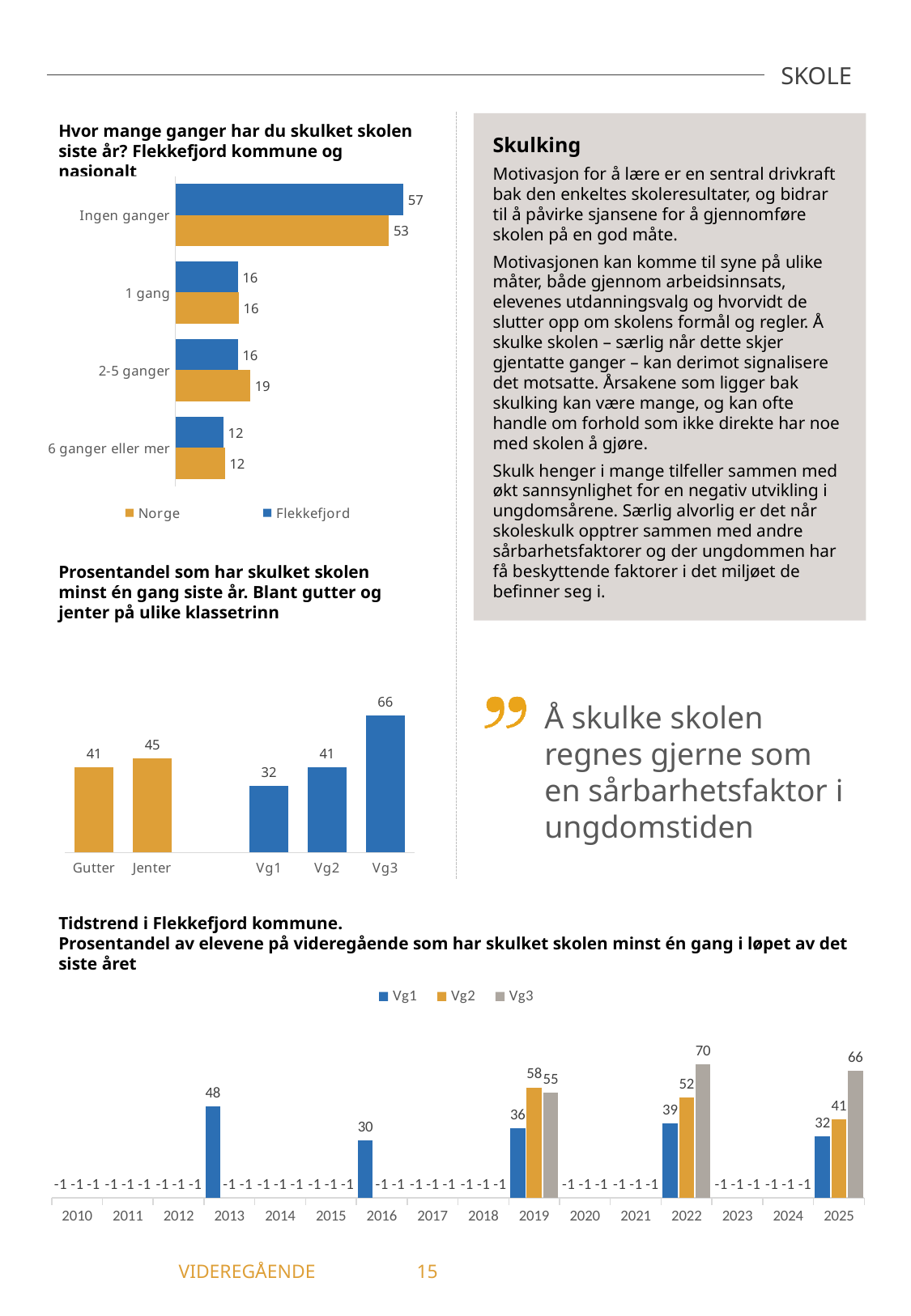
In the chart 'Tidstrend i Flekkefjord kommune', what is the value for Vg3 in 2022? 70 In the chart 'Prosentandel som har skulket skolen minst én gang siste år', which category has the lowest value? Vg1 In the chart 'Hvor mange ganger har du skulket skolen siste år?', what is the value for Flekkefjord in the category 'Ingen ganger'? 57 In the chart 'Tidstrend i Flekkefjord kommune', which is larger in 2019: the value for Vg2 or Vg3? Vg2 What kind of chart is the 'Tidstrend i Flekkefjord kommune' chart? Bar chart In the chart 'Prosentandel som har skulket skolen minst én gang siste år', what is the difference between the values for Vg3 and Vg1? 34 In the chart 'Prosentandel som har skulket skolen minst én gang siste år', what is the value for Jenter? 45 In the chart 'Prosentandel som har skulket skolen minst én gang siste år', which category has the highest value? Vg3 In the chart 'Hvor mange ganger har du skulket skolen siste år?', what is the difference between the Flekkefjord and Norge values for 'Ingen ganger'? 4 In the chart 'Tidstrend i Flekkefjord kommune', what is the value for Vg1 in 2013? 48 In the chart 'Hvor mange ganger har du skulket skolen siste år?', what is the value for Norge in the category '2-5 ganger'? 19 In the chart 'Hvor mange ganger har du skulket skolen siste år?', how many series does the legend list? 2